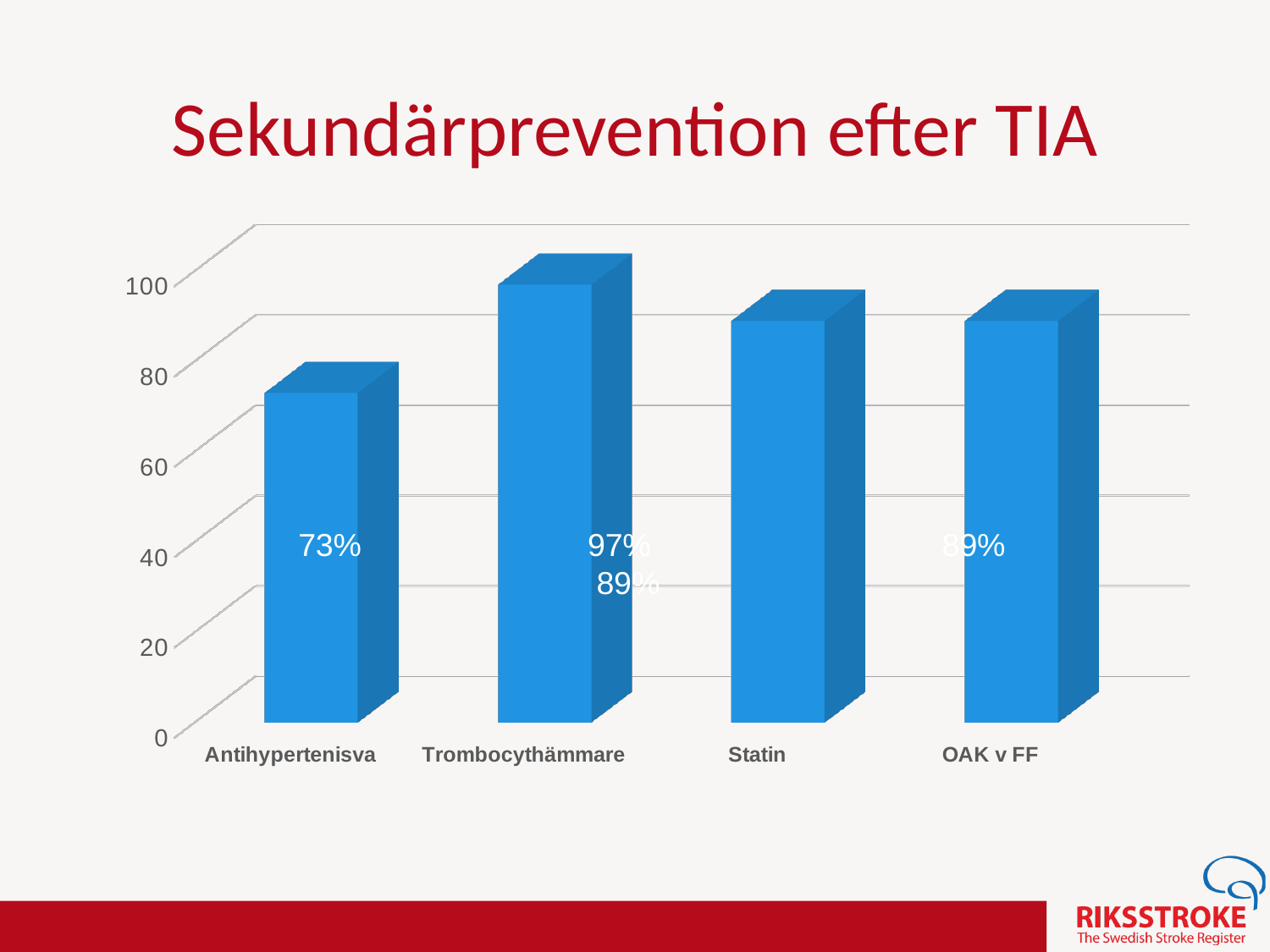
Which category has the highest value? Trombocythämmare Is the value for Antihypertenisva greater or less than 80? less What is the difference between the values for Trombocythämmare and Antihypertenisva? 24 percentage points What is the value for Trombocythämmare? 97% What is the difference between the values for OAK v FF and Antihypertenisva? 16 percentage points How many categories are shown on the x axis? 4 Is the value for Statin greater or less than 80? greater Which is larger, the value for Trombocythämmare or the value for OAK v FF? Trombocythämmare What is the value for Antihypertenisva? 73% What kind of chart is shown on the slide? bar chart Which category has the lowest value? Antihypertenisva What is the value for OAK v FF? 89%